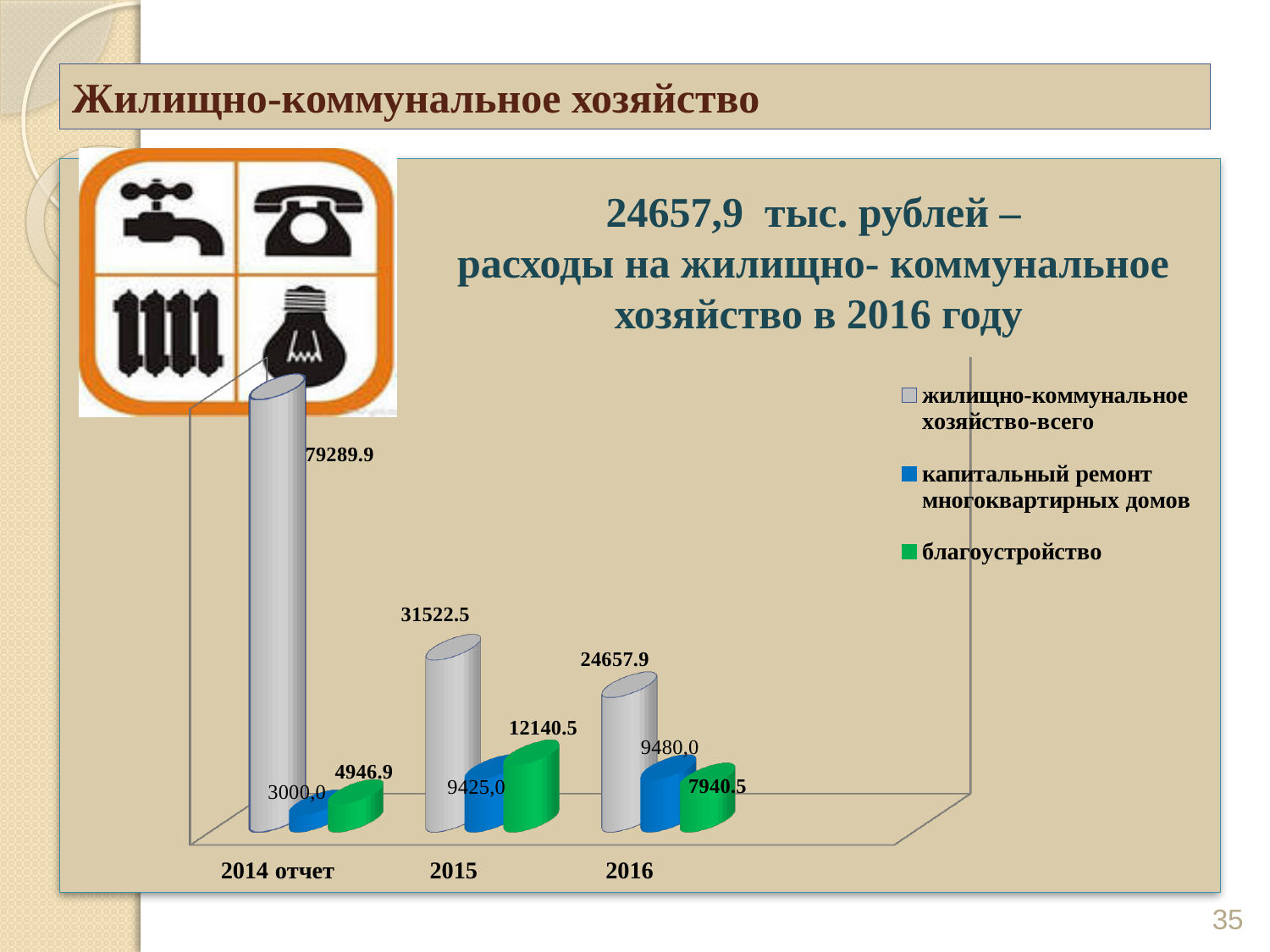
In which year is the value for жилищно-коммунальное хозяйство-всего highest? 2014 отчет In which year is the value for благоустройство lowest? 2014 отчет How many series does the chart legend list? 3 What is the difference between the жилищно-коммунальное хозяйство-всего values for 2014 отчет and 2015? 47767.4 How many years are shown on the x axis of the chart? 3 What kind of chart is shown on the slide? bar chart What is the value for благоустройство in 2015? 12140.5 What is the value for жилищно-коммунальное хозяйство-всего in 2016? 24657.9 What is the value for жилищно-коммунальное хозяйство-всего in 2014 отчет? 79289.9 Which is larger in 2016: капитальный ремонт многоквартирных домов or благоустройство? капитальный ремонт многоквартирных домов What is the difference between the благоустройство values for 2015 and 2016? 4200.0 What is the value for капитальный ремонт многоквартирных домов in 2016? 9480,0